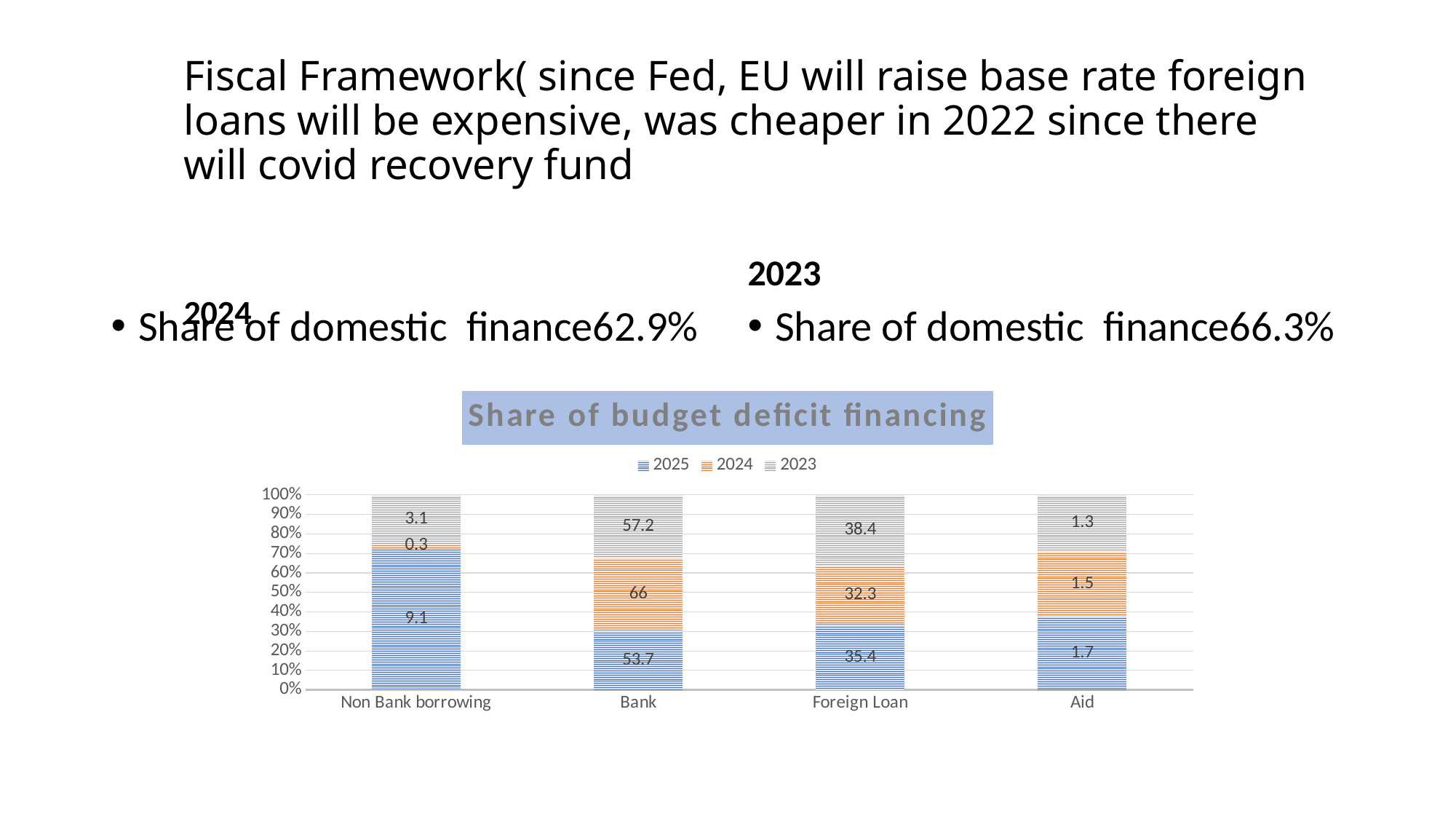
Which is larger for Foreign Loan, the 2025 value or the 2024 value? 2025 Which category has the highest 2024 value? Bank How many series does the legend list? 3 What is the 2024 value for Aid? 1.5 What is the 2024 value for Non Bank borrowing? 0.3 What is the title of the chart? Share of budget deficit financing What kind of chart is shown on the slide? Stacked bar chart How many categories are shown on the x axis? 4 What is the difference between the 2024 and 2025 values for Bank? 12.3 Which category has the lowest 2023 value? Aid What is the 2023 value for Foreign Loan? 38.4 What is the 2025 value for Bank in the Share of budget deficit financing chart? 53.7